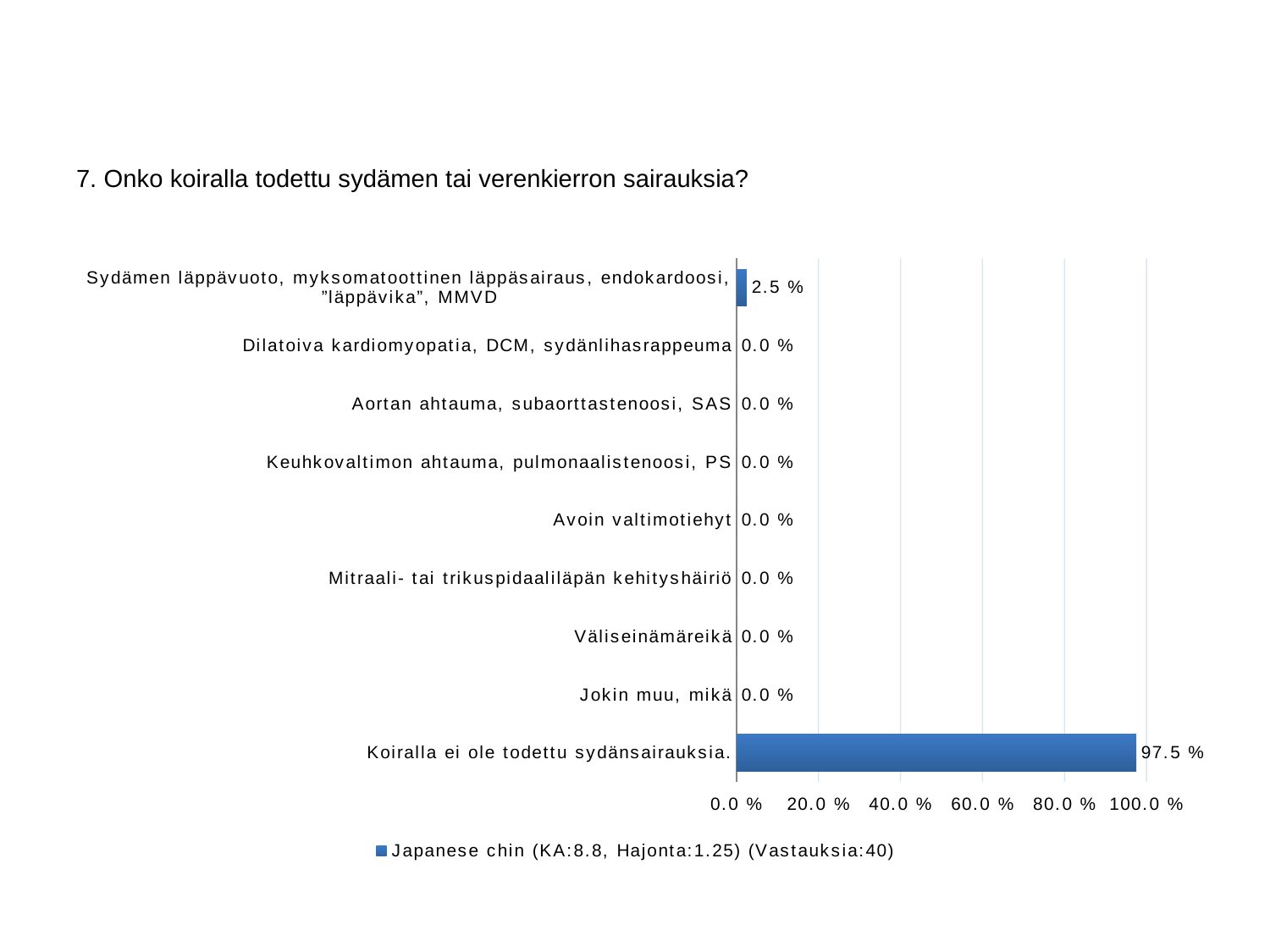
Which category has the highest value? Koiralla ei ole todettu sydänsairauksia. Is the value for "Koiralla ei ole todettu sydänsairauksia." greater or less than 80.0 %? greater Which is larger: the value for "Koiralla ei ole todettu sydänsairauksia." or the value for "Jokin muu, mikä"? Koiralla ei ole todettu sydänsairauksia. What is the value for "Dilatoiva kardiomyopatia, DCM, sydänlihasrappeuma"? 0.0 % How many series does the legend list? 1 What is the legend entry of the series shown in the chart? Japanese chin (KA:8.8, Hajonta:1.25) (Vastauksia:40) What is the difference between the values for "Koiralla ei ole todettu sydänsairauksia." and "Sydämen läppävuoto, myksomatoottinen läppäsairaus, endokardoosi, "läppävika", MMVD"? 95.0 % How many categories have a value of 0.0 %? 7 What kind of chart is shown on the slide? bar chart What is the value for "Sydämen läppävuoto, myksomatoottinen läppäsairaus, endokardoosi, "läppävika", MMVD"? 2.5 % How many categories are shown in the chart? 9 What is the value for "Koiralla ei ole todettu sydänsairauksia."? 97.5 %